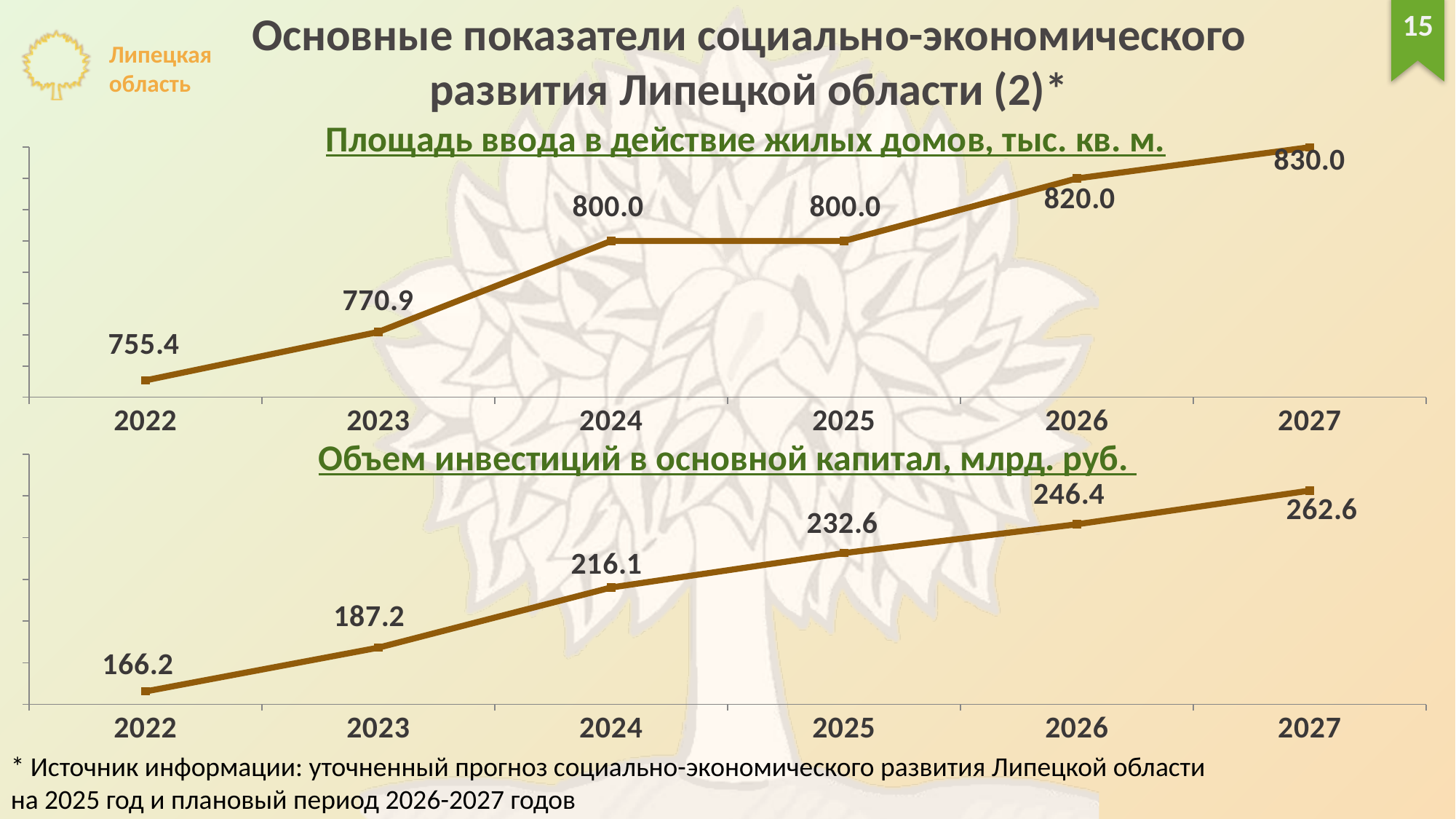
In the top chart (Площадь ввода в действие жилых домов), what is the difference between the 2027 and 2026 values? 10.0 In the top chart (Площадь ввода в действие жилых домов), what is the value for 2023? 770.9 In the bottom chart (Объем инвестиций в основной капитал), what is the value for 2025? 232.6 In the bottom chart (Объем инвестиций в основной капитал), what is the difference between the 2024 and 2023 values? 28.9 In the top chart (Площадь ввода в действие жилых домов), which year has the lowest value? 2022 In the top chart (Площадь ввода в действие жилых домов), which year has the highest value? 2027 What type of chart is the bottom chart (Объем инвестиций в основной капитал)? Line chart In the bottom chart (Объем инвестиций в основной капитал), do the values rise or fall from 2022 to 2027? Rise In the top chart (Площадь ввода в действие жилых домов), how many data points are plotted? 6 In the top chart (Площадь ввода в действие жилых домов), what is the value for 2022? 755.4 In the bottom chart (Объем инвестиций в основной капитал), what is the value for 2027? 262.6 In the bottom chart (Объем инвестиций в основной капитал), which is larger: the value for 2022 or the value for 2026? 2026